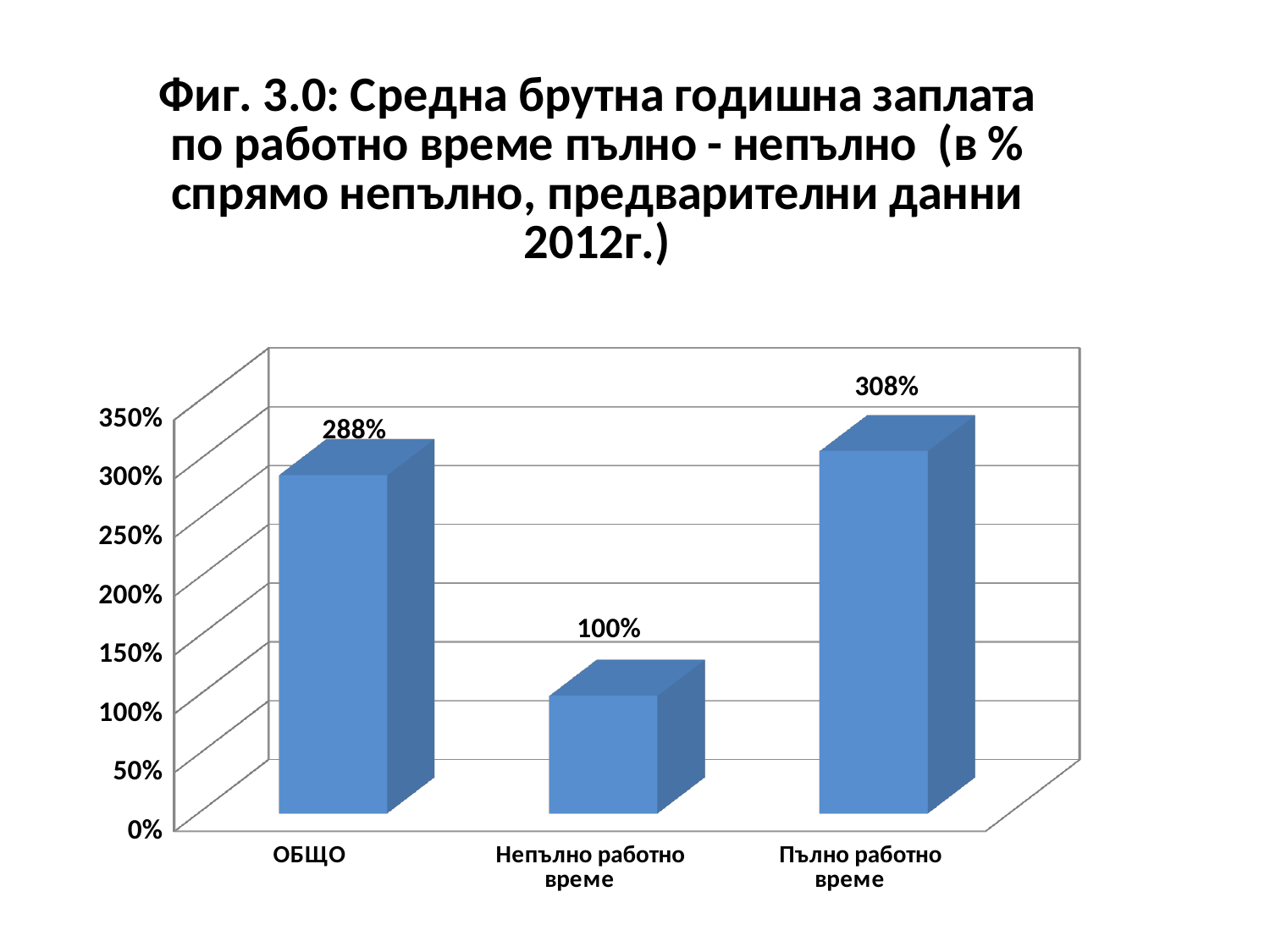
How many categories are shown on the chart? 3 Which category has the highest value? Пълно работно време Is the value for Пълно работно време greater or less than 300%? greater What kind of chart is shown on the slide? bar chart What is the difference between the values for ОБЩО and Непълно работно време? 188% Which category has the lowest value? Непълно работно време What is the value for ОБЩО? 288% Which is larger, the value for ОБЩО or the value for Непълно работно време? ОБЩО What is the difference between the values for Пълно работно време and ОБЩО? 20% What is the figure number given in the chart title? Фиг. 3.0 What is the value for Пълно работно време? 308% What is the value for Непълно работно време? 100%